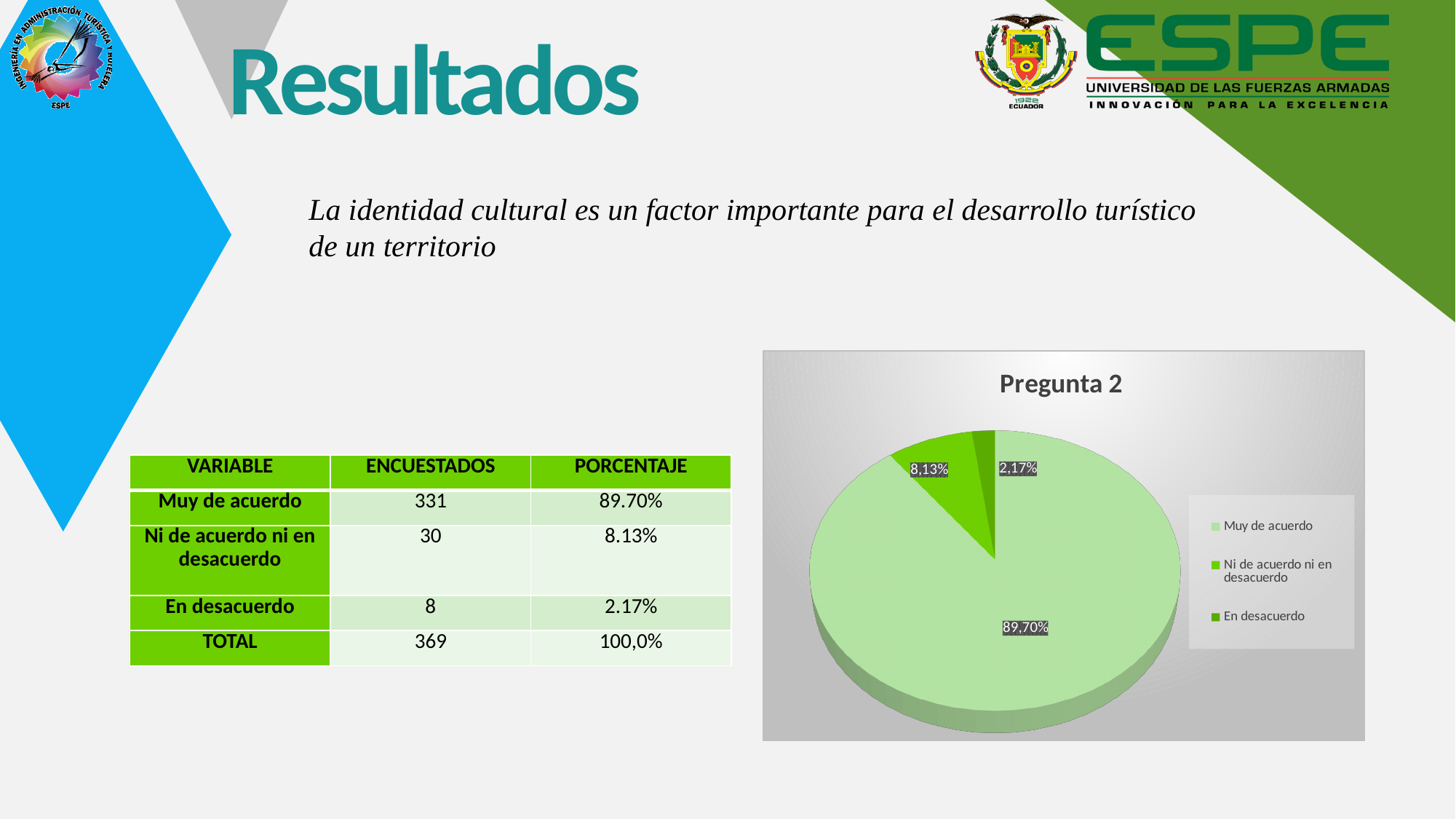
Which legend entry is shown in the lightest green colour? Muy de acuerdo What is the title of the chart? Pregunta 2 Which category has the largest slice in the pie chart? Muy de acuerdo What is the difference in percentage points between the Ni de acuerdo ni en desacuerdo slice and the En desacuerdo slice? 5,96 What percentage does the chart show for En desacuerdo? 2,17% What percentage does the chart show for Muy de acuerdo? 89,70% How many slices does the pie chart have? 3 What percentage does the chart show for Ni de acuerdo ni en desacuerdo? 8,13% What type of chart is shown on the slide? Pie chart How many entries does the chart legend list? 3 Which category has the smallest slice in the pie chart? En desacuerdo Which slice is larger: Ni de acuerdo ni en desacuerdo or En desacuerdo? Ni de acuerdo ni en desacuerdo